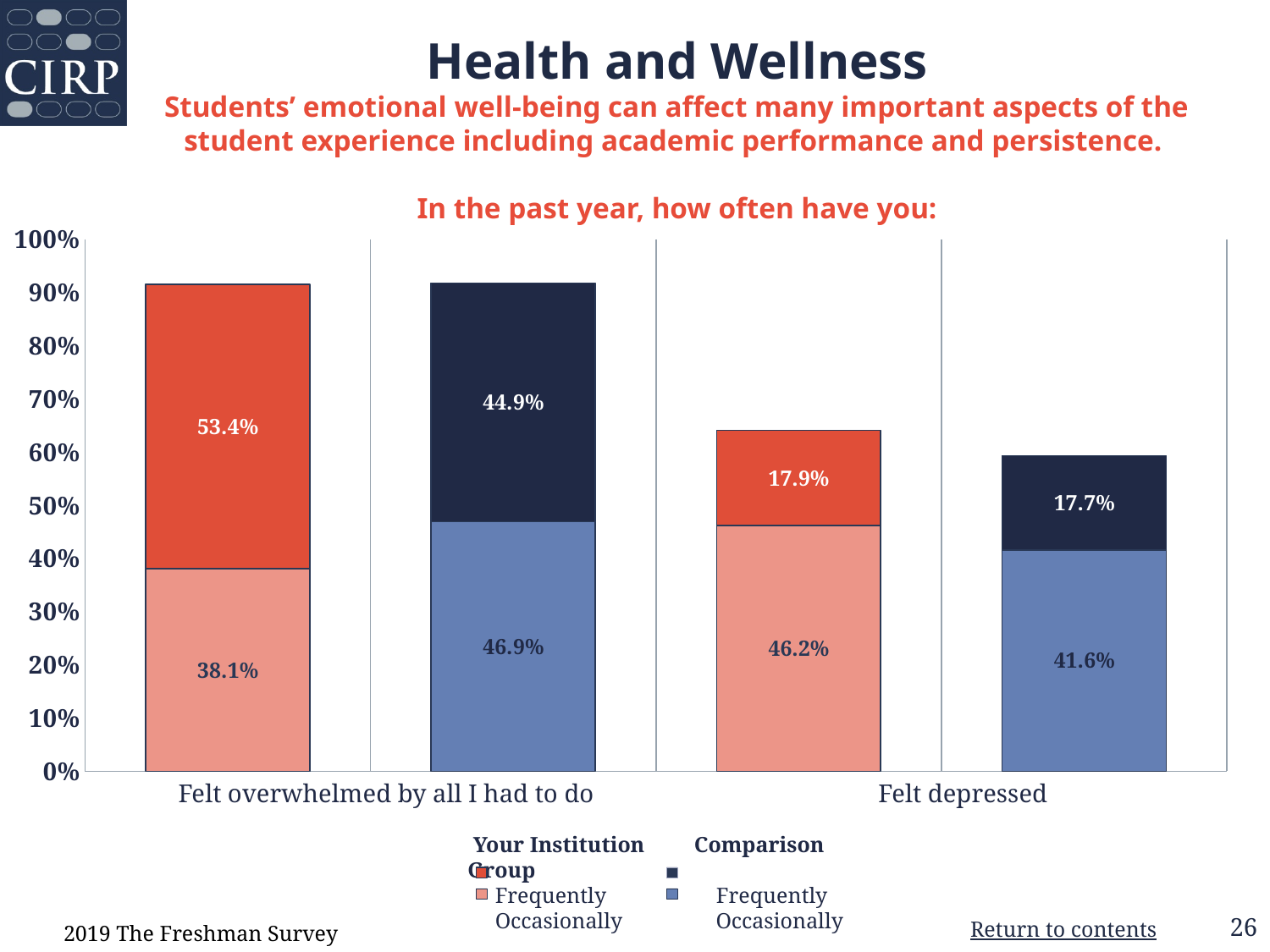
What is the combined percentage (frequently plus occasionally) of Your Institution students who felt overwhelmed by all they had to do? 91.5% What is the combined percentage (frequently plus occasionally) of the Comparison Group who felt depressed? 59.3% What percentage of the Comparison Group reported occasionally feeling depressed? 41.6% Which segment has the lowest labeled value in the chart? Comparison Group Frequently, Felt depressed (17.7%) What percentage of students at Your Institution reported occasionally feeling depressed? 46.2% Which segment has the highest labeled value in the chart? Your Institution Frequently, Felt overwhelmed by all I had to do (53.4%) What type of chart is shown on the slide? Stacked bar chart Which is larger: the Your Institution percentage for occasionally feeling depressed or the Comparison Group percentage for occasionally feeling depressed? Your Institution What percentage of students at Your Institution reported frequently feeling overwhelmed by all they had to do? 53.4% How many series does the legend list? 4 What percentage of the Comparison Group reported frequently feeling overwhelmed by all they had to do? 44.9% What is the difference between the Your Institution and Comparison Group percentages for frequently feeling overwhelmed by all they had to do? 8.5%